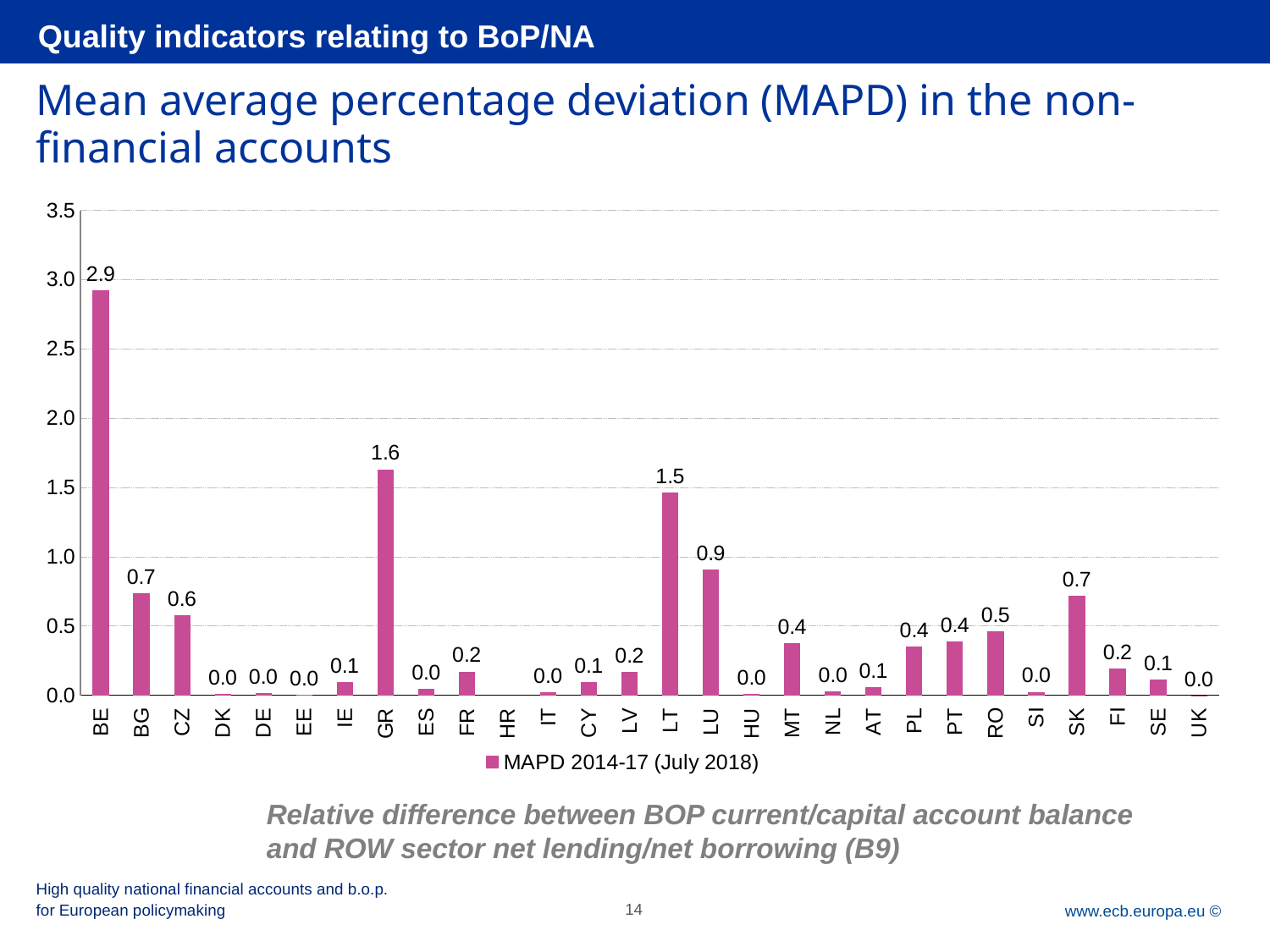
What is the difference between the MAPD values for GR and LT? 0.1 What is the MAPD value for GR? 1.6 Which has a larger MAPD value, LU or SK? LU What is the MAPD value for RO? 0.5 What is the MAPD value for LT? 1.5 Which country has the highest MAPD value? BE What kind of chart is shown on the slide? bar chart What is the MAPD value for BE? 2.9 What is the legend entry for the series shown in the chart? MAPD 2014-17 (July 2018) How many series does the legend list? 1 How many countries are shown on the x axis of the chart? 28 Is the value for BE greater or less than 2.5? greater